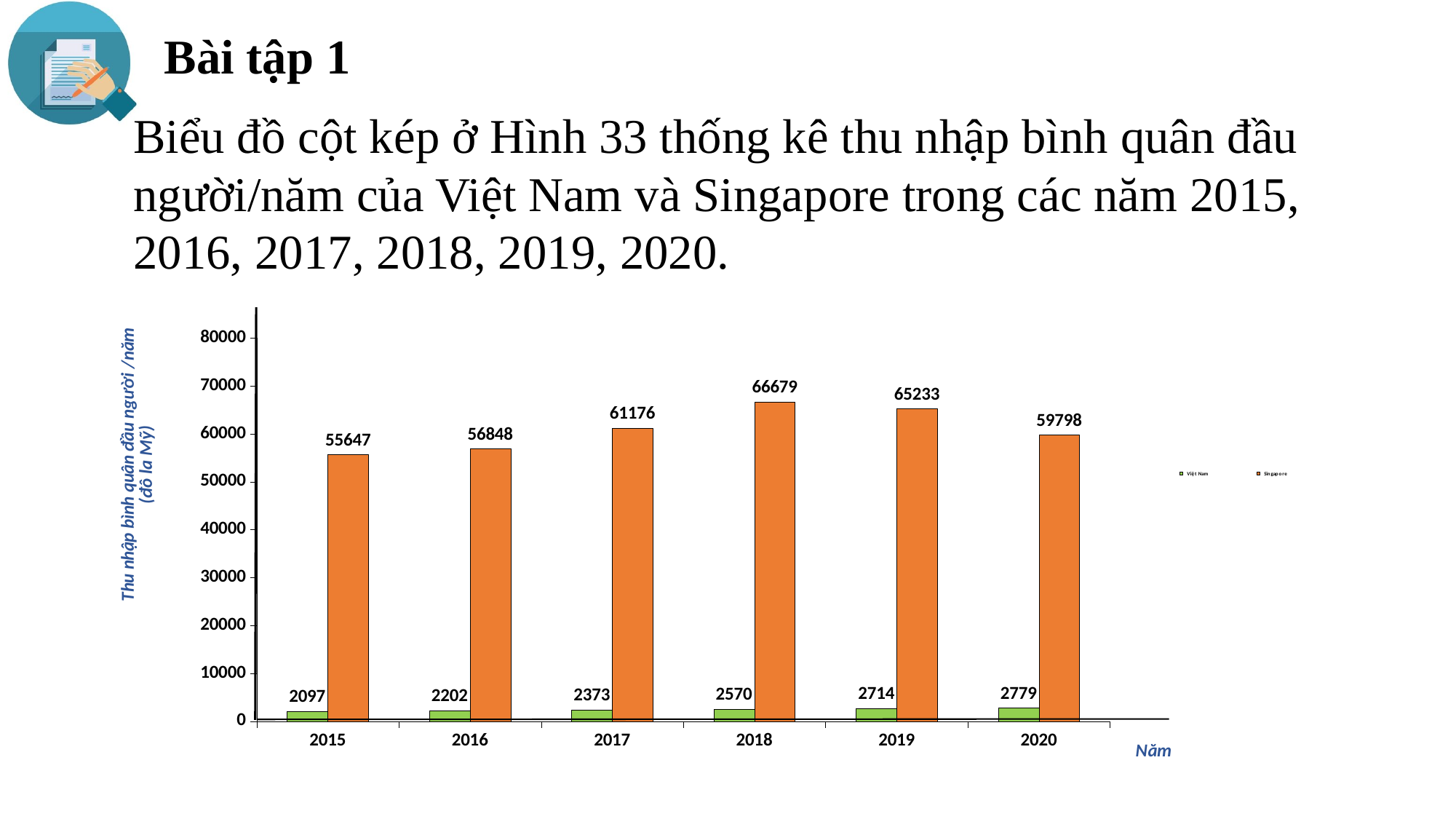
In which year is the value for Singapore highest? 2018 Do the values for Việt Nam rise or fall from 2015 to 2020? rise Is the value for Singapore in 2017 greater or less than 60000? greater Which is larger: the Việt Nam value in 2020 or the Việt Nam value in 2016? 2020 What kind of chart is shown? bar chart What is the difference between the Singapore value in 2019 and the Singapore value in 2020? 5435 In which year is the value for Việt Nam lowest? 2015 What is the value for Singapore in 2018? 66679 What is the value for Singapore in 2020? 59798 How many years are shown on the x axis? 6 What is the value for Việt Nam in 2015? 2097 How many series does the legend list? 2